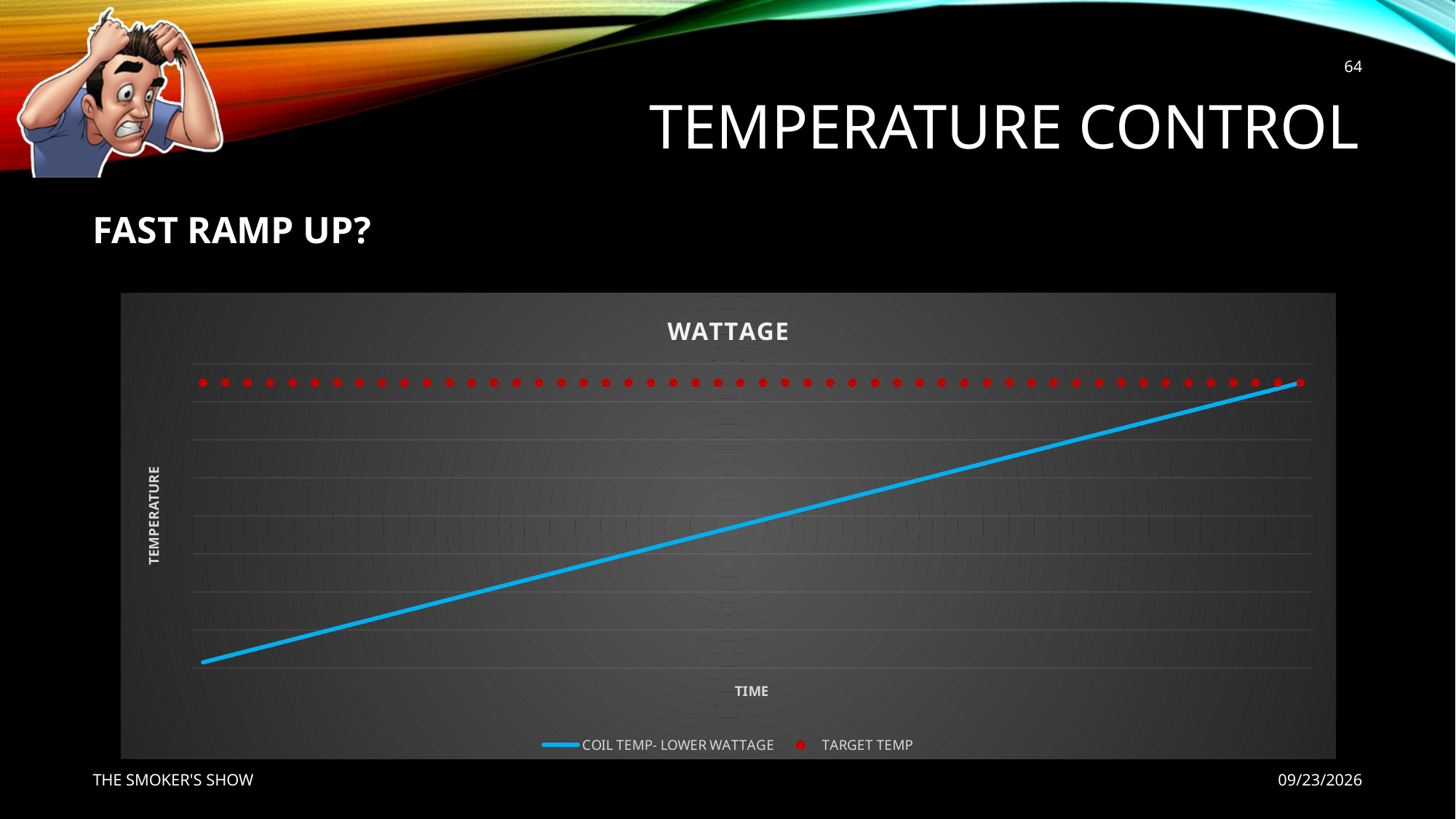
How many series does the chart's legend list? 2 Does the COIL TEMP- LOWER WATTAGE line rise or fall as time increases along the x axis? rises What kind of chart is shown on the slide? line chart What is the title of the chart? WATTAGE Does the TARGET TEMP series rise, fall, or stay flat along the x axis? stays flat At the left end of the chart, which is higher: COIL TEMP- LOWER WATTAGE or TARGET TEMP? TARGET TEMP What label is shown on the chart's vertical axis? TEMPERATURE